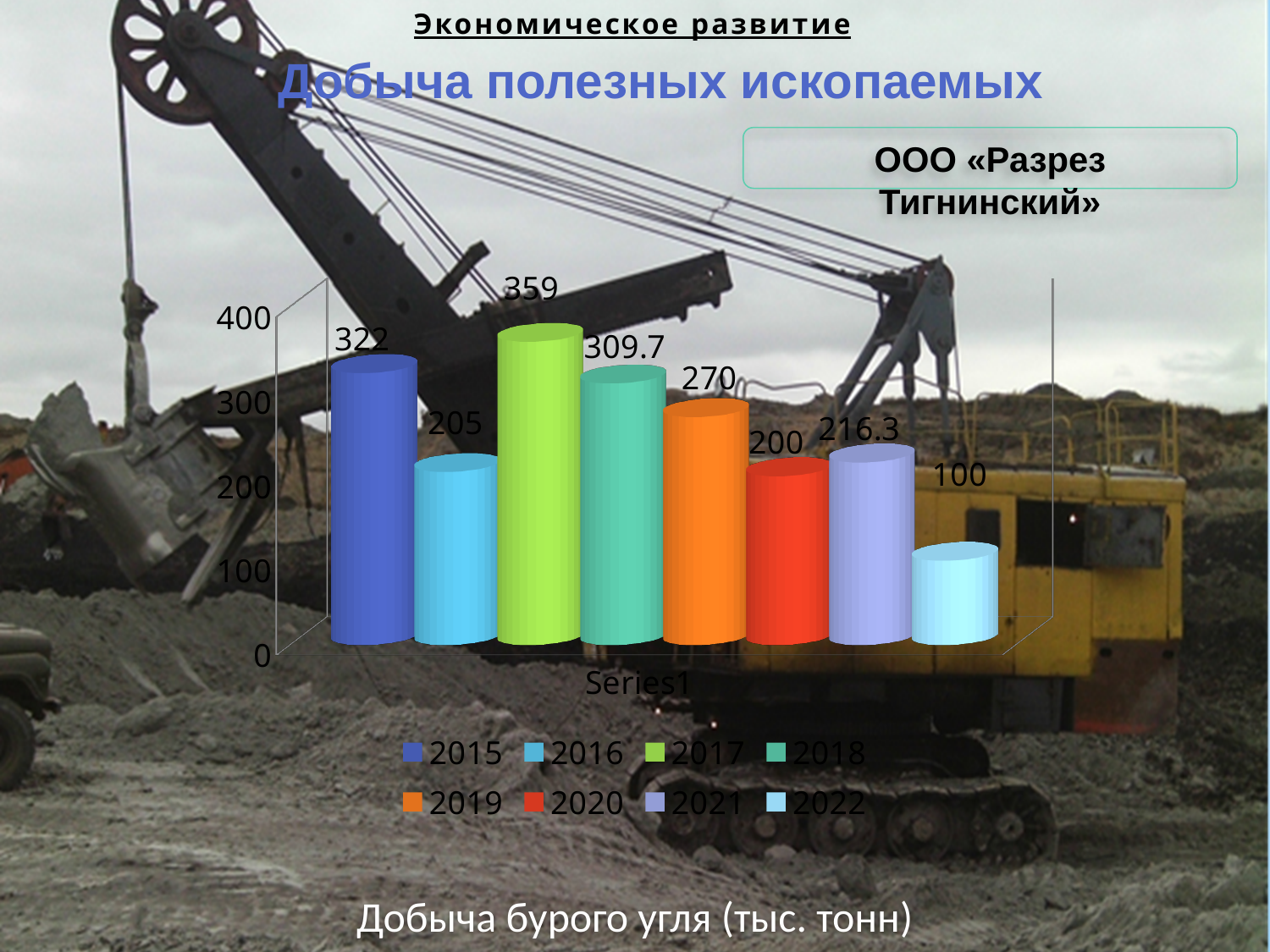
What is the value for 2018? 309.7 What is the difference between the values for 2017 and 2016? 154 Which year has the highest value? 2017 What kind of chart is shown on the slide? bar chart What is the value for 2021? 216.3 How many series does the legend list? 8 Which is larger, the value for 2015 or the value for 2018? 2015 What is the difference between the values for 2019 and 2020? 70 Is the value for 2019 greater or less than 200? greater What is the value for 2015? 322 Which year has the lowest value? 2022 What is the caption below the chart? Добыча бурого угля (тыс. тонн)